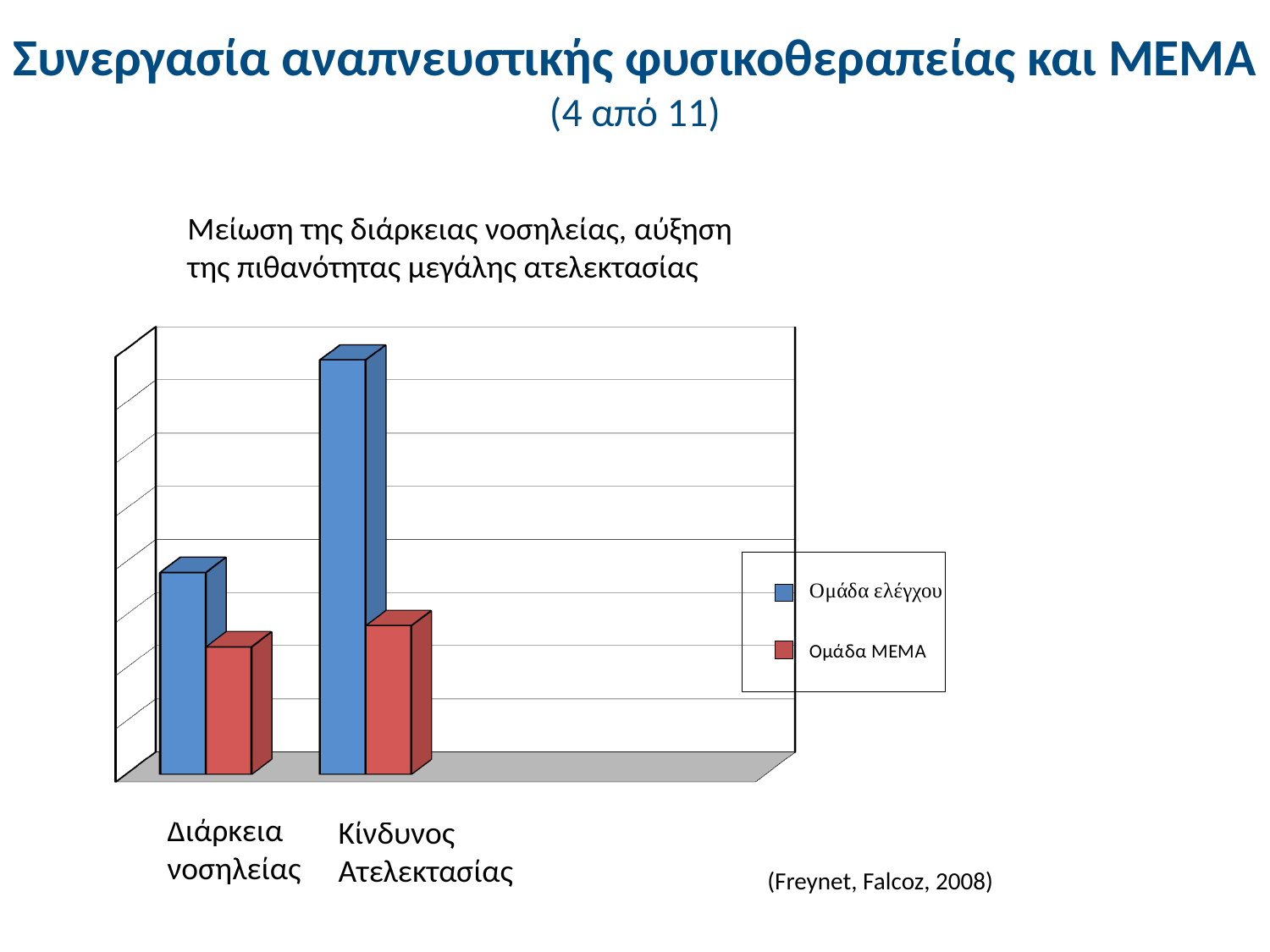
How many categories are shown on the x axis of the chart? 2 For Διάρκεια νοσηλείας, which group has the larger value, Ομάδα ελέγχου or Ομάδα ΜΕΜΑ? Ομάδα ελέγχου For the Ομάδα ελέγχου series, does the value rise or fall from Διάρκεια νοσηλείας to Κίνδυνος Ατελεκτασίας? Rise For the Ομάδα ελέγχου series, which category has the higher value? Κίνδυνος Ατελεκτασίας Which is larger: Ομάδα ελέγχου for Κίνδυνος Ατελεκτασίας or Ομάδα ελέγχου for Διάρκεια νοσηλείας? Ομάδα ελέγχου for Κίνδυνος Ατελεκτασίας For Κίνδυνος Ατελεκτασίας, which group has the larger value, Ομάδα ελέγχου or Ομάδα ΜΕΜΑ? Ομάδα ελέγχου Which colour represents Ομάδα ΜΕΜΑ in the chart? Red Which bar is the tallest in the chart? Ομάδα ελέγχου for Κίνδυνος Ατελεκτασίας How many series does the chart's legend list? 2 What are the two series listed in the chart's legend? Ομάδα ελέγχου and Ομάδα ΜΕΜΑ What kind of chart is shown on the slide? Bar chart